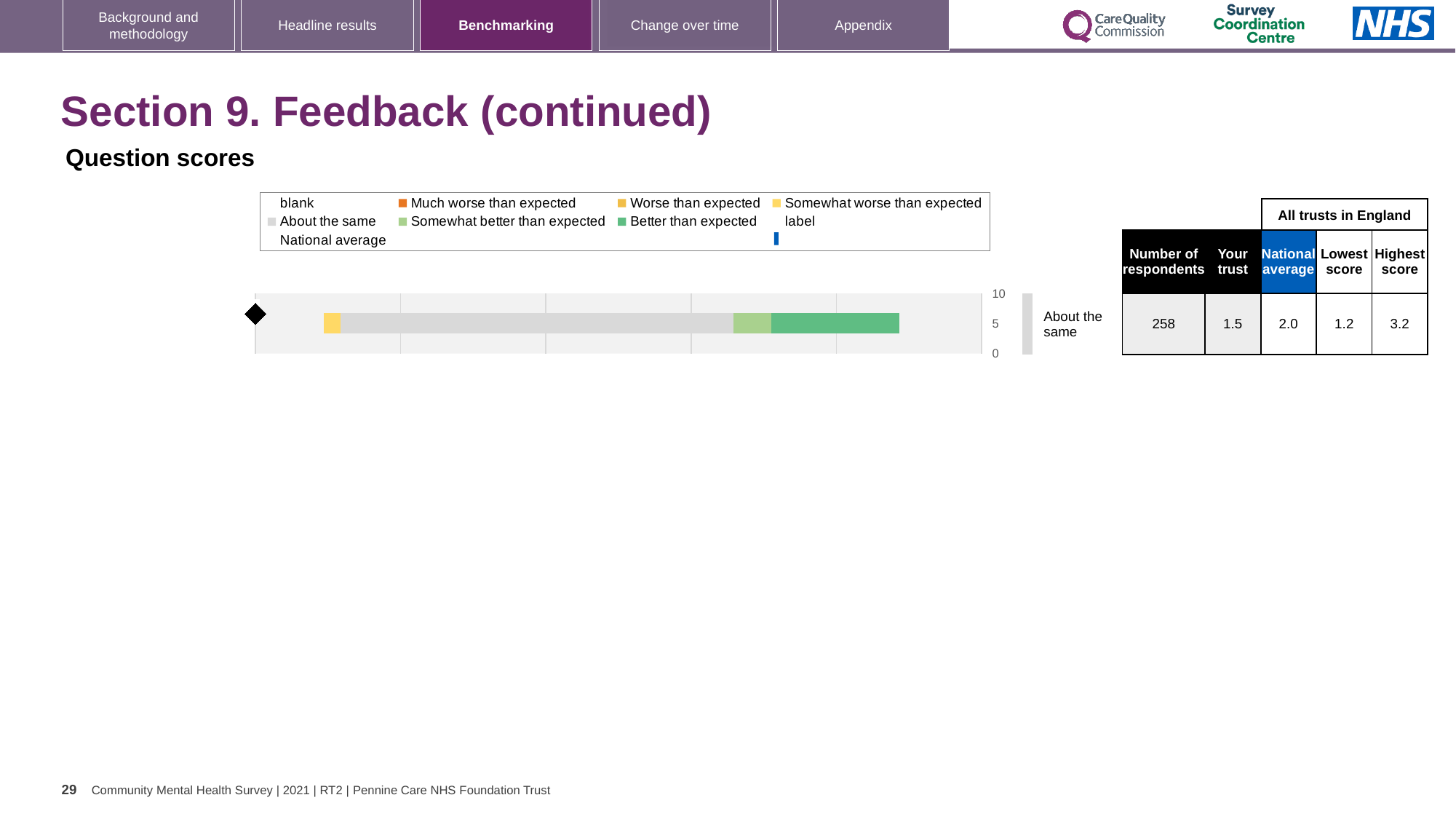
What kind of chart is shown on the slide? bar chart Which is larger for the 'About the same' row: the Your trust score or the National average? National average What is the difference between the National average and the Your trust score for the 'About the same' row? 0.5 How many bars are plotted in the chart? 1 What is the difference between the Highest score and the Lowest score for the 'About the same' row? 2.0 What colour does the legend use for 'Better than expected'? green What is the 'Your trust' score shown for the 'About the same' row? 1.5 How many respondents are shown for the 'About the same' row? 258 What is the Lowest score among all trusts in England shown for the 'About the same' row? 1.2 What is the category label shown next to the bar in the chart? About the same What is the National average score shown for the 'About the same' row? 2.0 What is the Highest score among all trusts in England shown for the 'About the same' row? 3.2